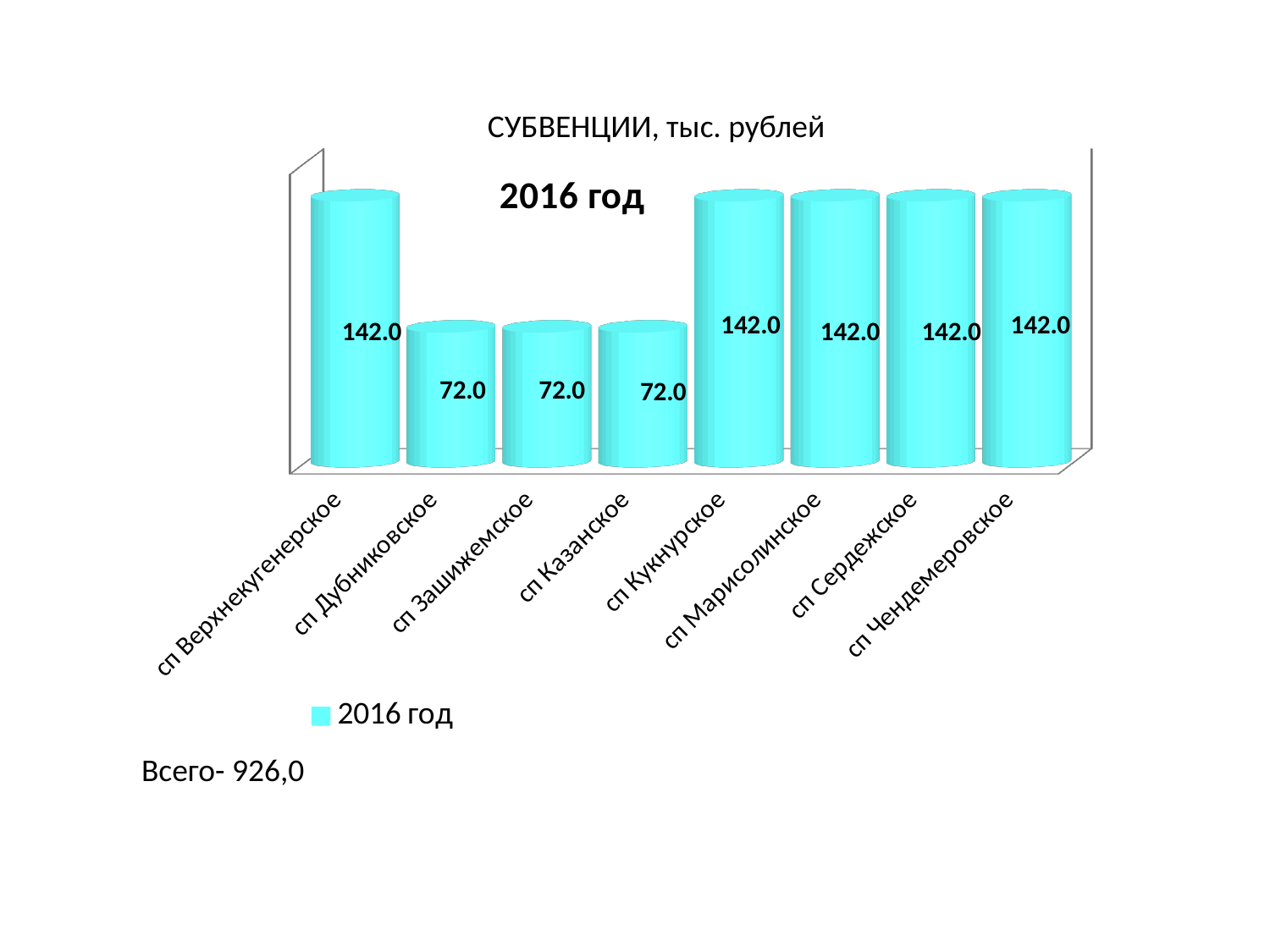
How many categories are shown on the x axis? 8 Which is larger, the value for сп Сердежское or the value for сп Казанское? сп Сердежское What is the difference between the values for сп Кукнурское and сп Зашижемское? 70.0 What is the title of the chart? 2016 год What is the value for сп Чендемеровское? 142.0 What is the value for сп Казанское? 72.0 What is the value for сп Марисолинское? 142.0 What series name is listed in the legend? 2016 год What is the value for сп Верхнекугенерское? 142.0 What kind of chart is shown on the slide? bar chart How many series does the legend list? 1 What is the value for сп Дубниковское? 72.0